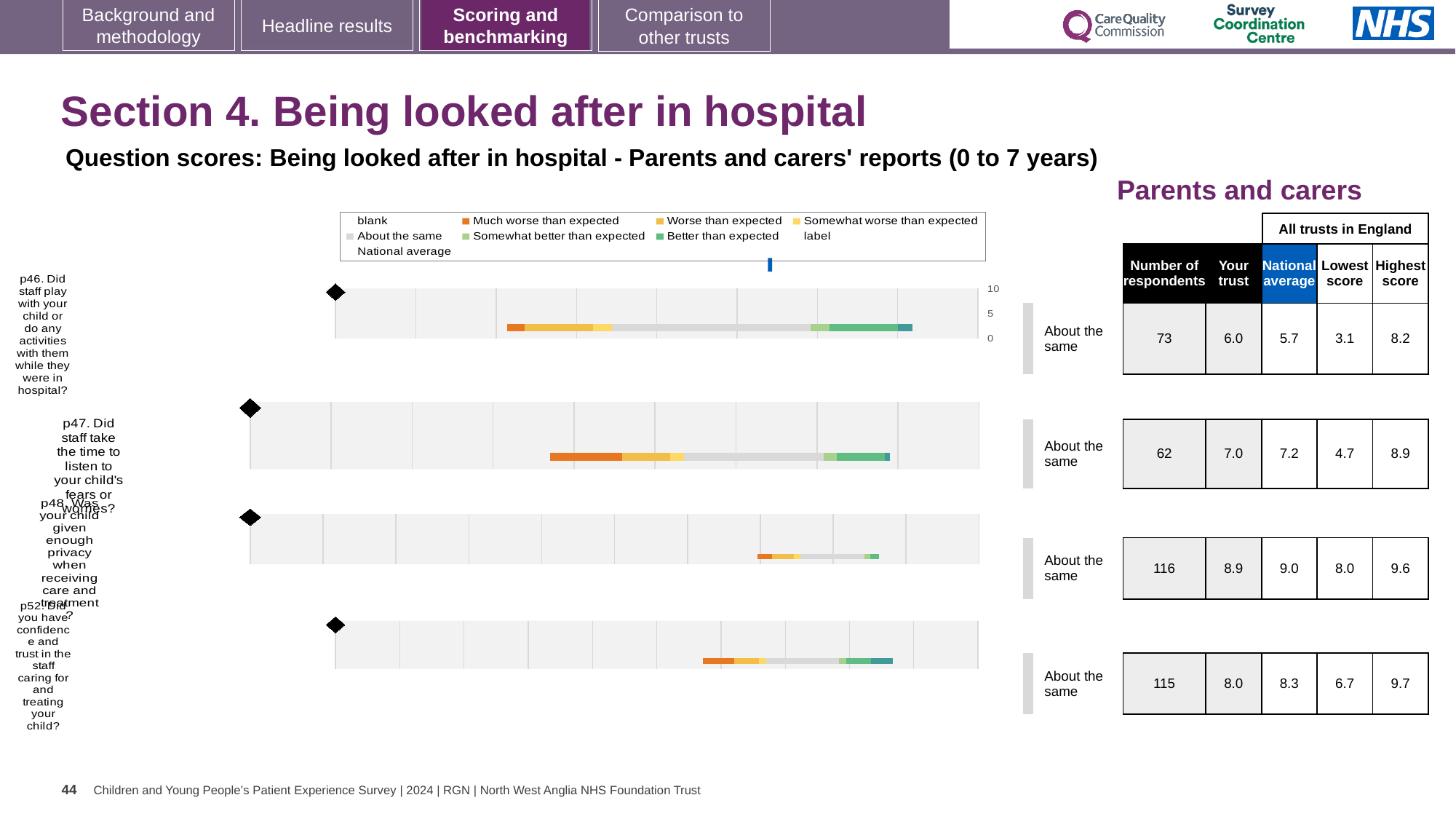
What is the difference between the national average and the 'Your trust' score for p52? 0.3 For p47, which is larger: the 'Your trust' score or the national average? National average How many respondents answered p48 (Was your child given enough privacy when receiving care and treatment?)? 116 What is the highest score among all trusts in England for p52 (Did you have confidence and trust in the staff caring for and treating your child?)? 9.7 Which question has the lowest 'Your trust' score? p46 What kind of chart is used to show the question scores? Bar chart What is the 'Your trust' score for p46 (Did staff play with your child or do any activities with them while they were in hospital?)? 6.0 What benchmark category is shown next to each of the four questions? About the same How many questions are plotted on the chart? 4 Which question has the highest 'Your trust' score? p48 What is the lowest score among all trusts in England for p46? 3.1 What is the national average score for p47 (Did staff take the time to listen to your child's fears or worries?)? 7.2